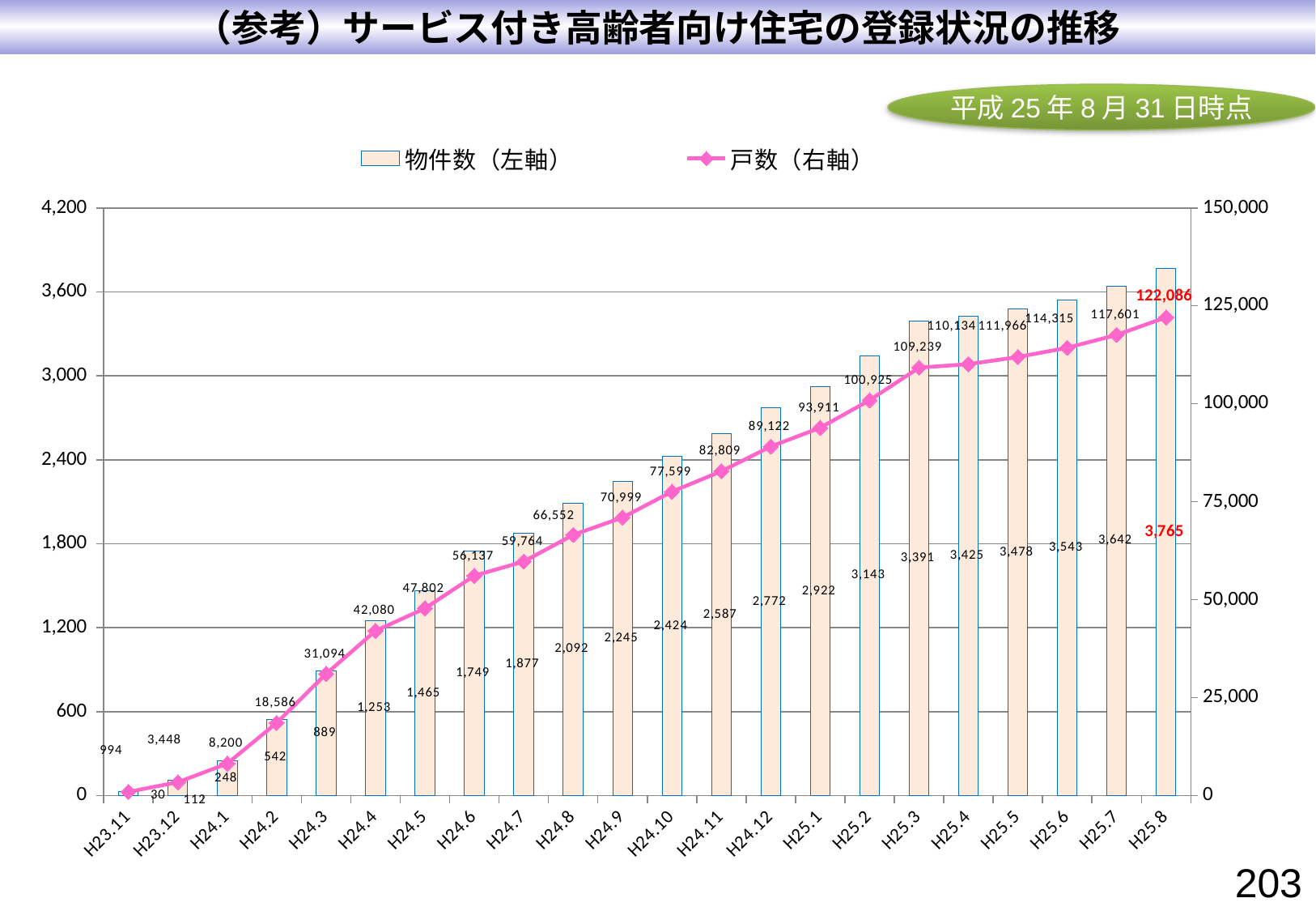
What is the difference in 物件数 between H25.8 and H25.7? 123 Which period has the lowest 物件数 value? H23.11 What is the 物件数 value for H25.8? 3,765 Which period has the highest 戸数 value? H25.8 Do the 戸数 values rise or fall from H23.11 to H25.8? rise How many periods are shown on the x axis? 22 How many series does the legend list? 2 Which is larger, the 物件数 value for H24.9 or for H24.5? H24.9 What is the 戸数 value for H25.8? 122,086 What is the 戸数 value for H24.6? 56,137 What is the 物件数 value for H24.12? 2,772 What is the difference in 戸数 between H25.2 and H25.1? 7,014